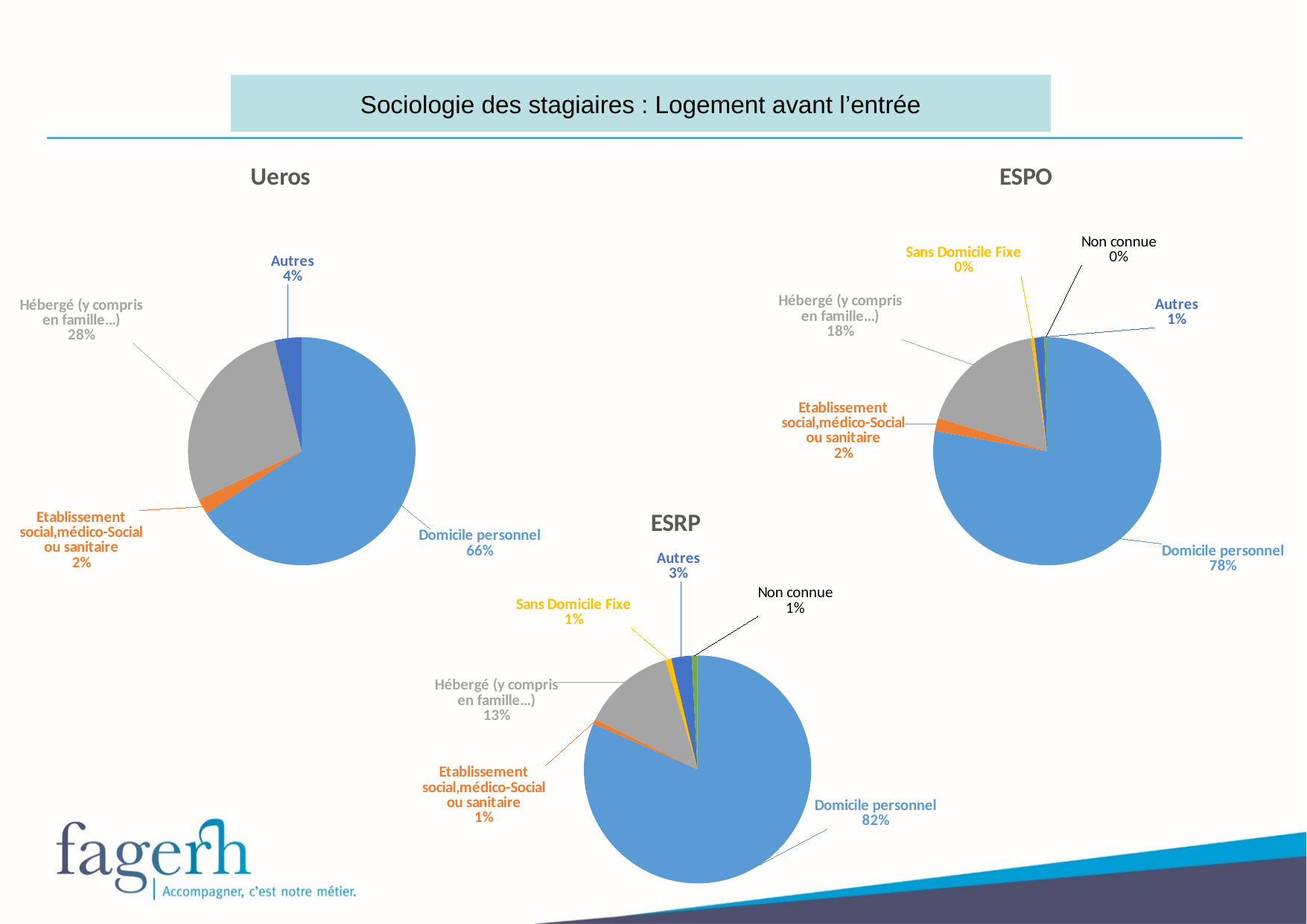
In the ESRP chart, which category has the largest share? Domicile personnel In the ESPO chart, what share does Domicile personnel have? 78% In the Ueros chart, what share does Domicile personnel have? 66% How many categories are shown in the Ueros chart? 4 In the ESRP chart, which is larger: the share of Autres or the share of Sans Domicile Fixe? Autres In the ESRP chart, what share does Hébergé (y compris en famille...) have? 13% What kind of chart is the ESRP chart? Pie chart How many categories are shown in the ESPO chart? 6 In the Ueros chart, which category has the smallest share? Etablissement social,médico-Social ou sanitaire What is the title of the slide? Sociologie des stagiaires : Logement avant l'entrée In the Ueros chart, what share does Hébergé (y compris en famille...) have? 28% In the ESPO chart, what is the difference between the shares of Domicile personnel and Hébergé (y compris en famille...)? 60%